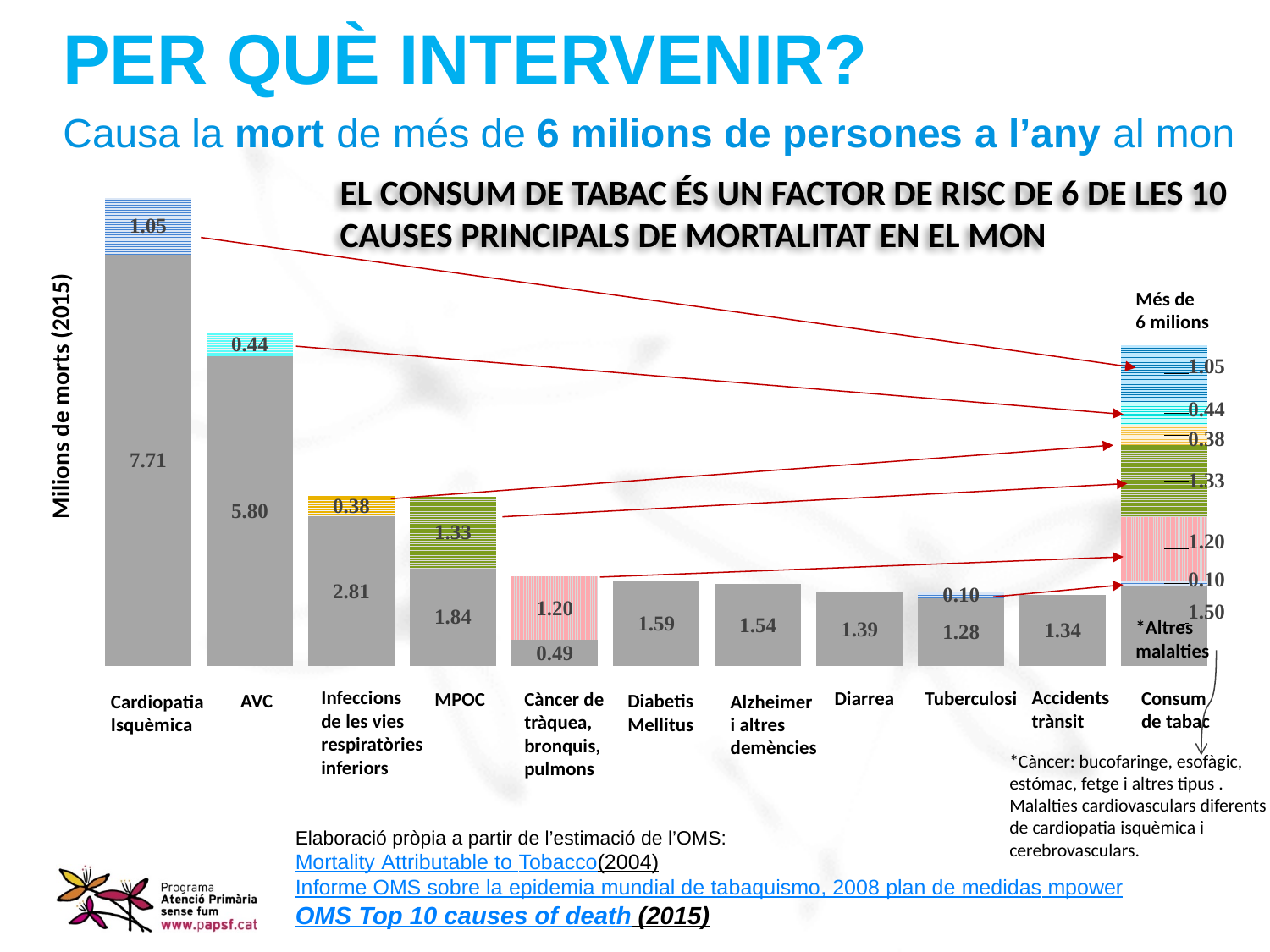
What is the total of the MPOC stacked bar (1.84 + 1.33)? 3.17 What is the tobacco-attributable value shown on top of the AVC bar? 0.44 What is the total of the Càncer de tràquea, bronquis, pulmons stacked bar (0.49 + 1.20)? 1.69 Which cause of death has the tallest bar in the chart? Cardiopatia Isquèmica What is the value of the 'Altres malalties' segment in the Consum de tabac bar? 1.50 How many categories are shown along the x axis of the chart? 11 What is the label of the y axis of the chart? Milions de morts (2015) What is the difference between the grey values for Cardiopatia Isquèmica (7.71) and AVC (5.80)? 1.91 What is the value shown for Diabetis Mellitus? 1.59 Which is larger, the value for Alzheimer i altres demències or the value for Diarrea? Alzheimer i altres demències What is the grey (non-tobacco) value shown for Cardiopatia Isquèmica? 7.71 What is the value of the green segment on the MPOC bar? 1.33